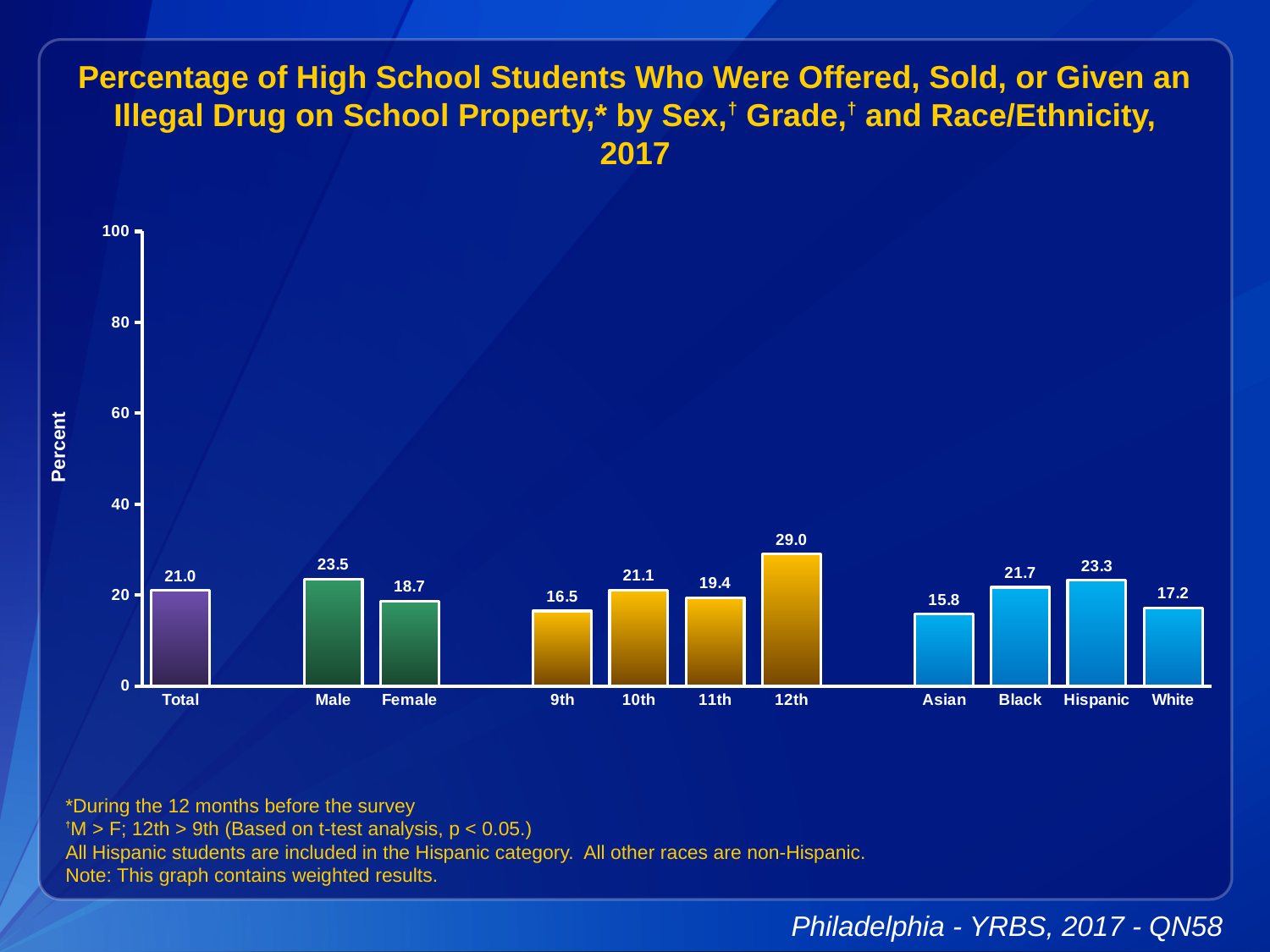
What is the label on the y axis? Percent What is the value for Male? 23.5 What is the value for Total? 21.0 Which is larger, the value for Hispanic or the value for White? Hispanic Which category has the lowest value? Asian Which category has the highest value? 12th How many bars are shown in the chart? 11 What is the difference between the Male and Female values? 4.8 What kind of chart is shown on the slide? bar chart Is the value for 9th grade greater or less than 20? less What is the value for 12th grade? 29.0 What is the value for Asian? 15.8